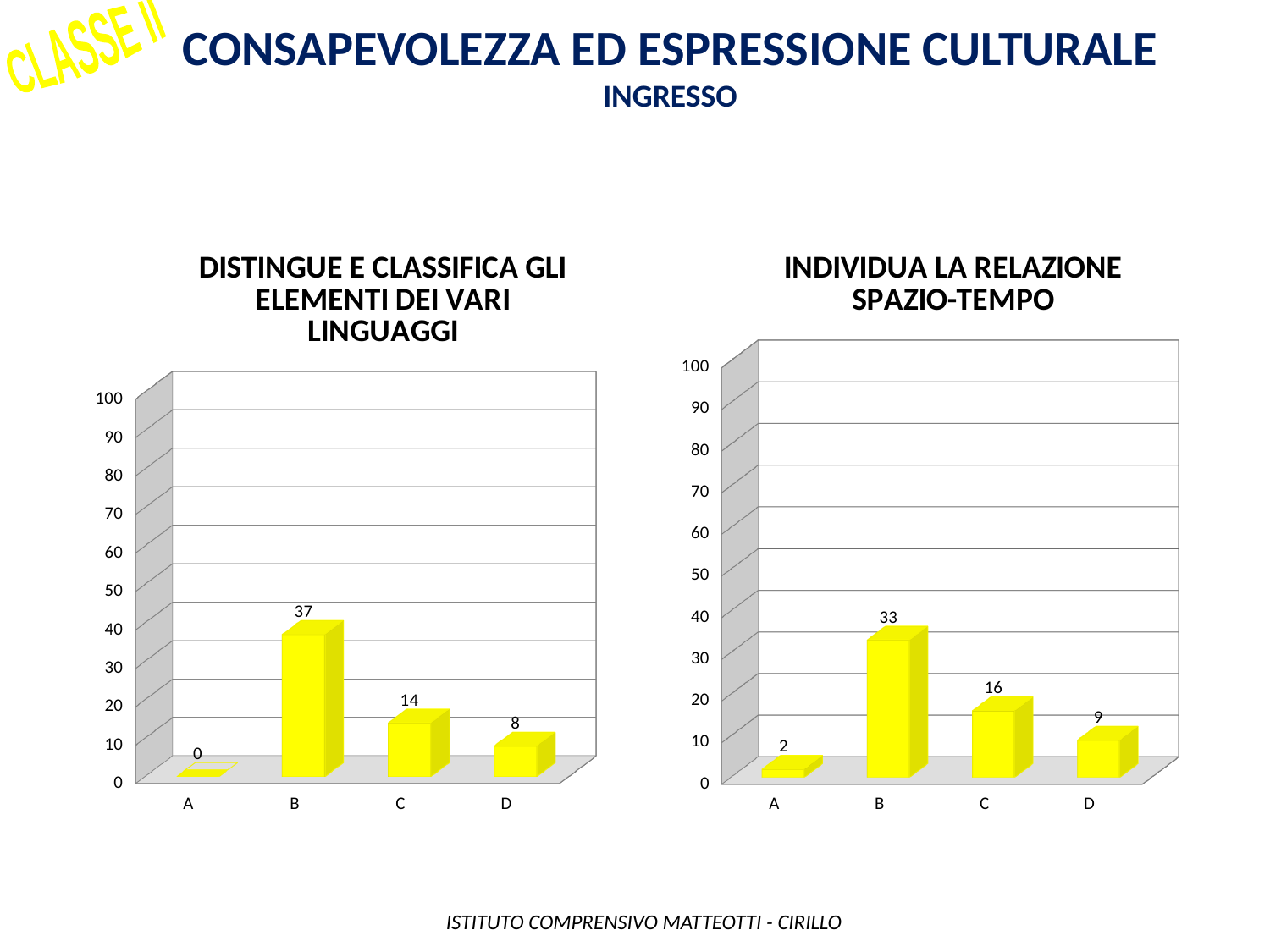
In the chart titled 'DISTINGUE E CLASSIFICA GLI ELEMENTI DEI VARI LINGUAGGI', what is the difference between the values for C and D? 6 How many categories are shown in the chart titled 'DISTINGUE E CLASSIFICA GLI ELEMENTI DEI VARI LINGUAGGI'? 4 In the chart titled 'INDIVIDUA LA RELAZIONE SPAZIO-TEMPO', which category has the lowest value? A In the chart titled 'INDIVIDUA LA RELAZIONE SPAZIO-TEMPO', what is the value for category C? 16 In the chart titled 'DISTINGUE E CLASSIFICA GLI ELEMENTI DEI VARI LINGUAGGI', what is the value for category B? 37 In the chart titled 'INDIVIDUA LA RELAZIONE SPAZIO-TEMPO', what is the difference between the values for B and C? 17 What is the subtitle shown under the main slide title? INGRESSO In the chart titled 'INDIVIDUA LA RELAZIONE SPAZIO-TEMPO', which is larger, the value for C or the value for D? C What kind of chart is the chart titled 'INDIVIDUA LA RELAZIONE SPAZIO-TEMPO'? Bar chart In the chart titled 'DISTINGUE E CLASSIFICA GLI ELEMENTI DEI VARI LINGUAGGI', which category has the highest value? B In the chart titled 'INDIVIDUA LA RELAZIONE SPAZIO-TEMPO', what is the value for category A? 2 In the chart titled 'DISTINGUE E CLASSIFICA GLI ELEMENTI DEI VARI LINGUAGGI', which category has the lowest value? A